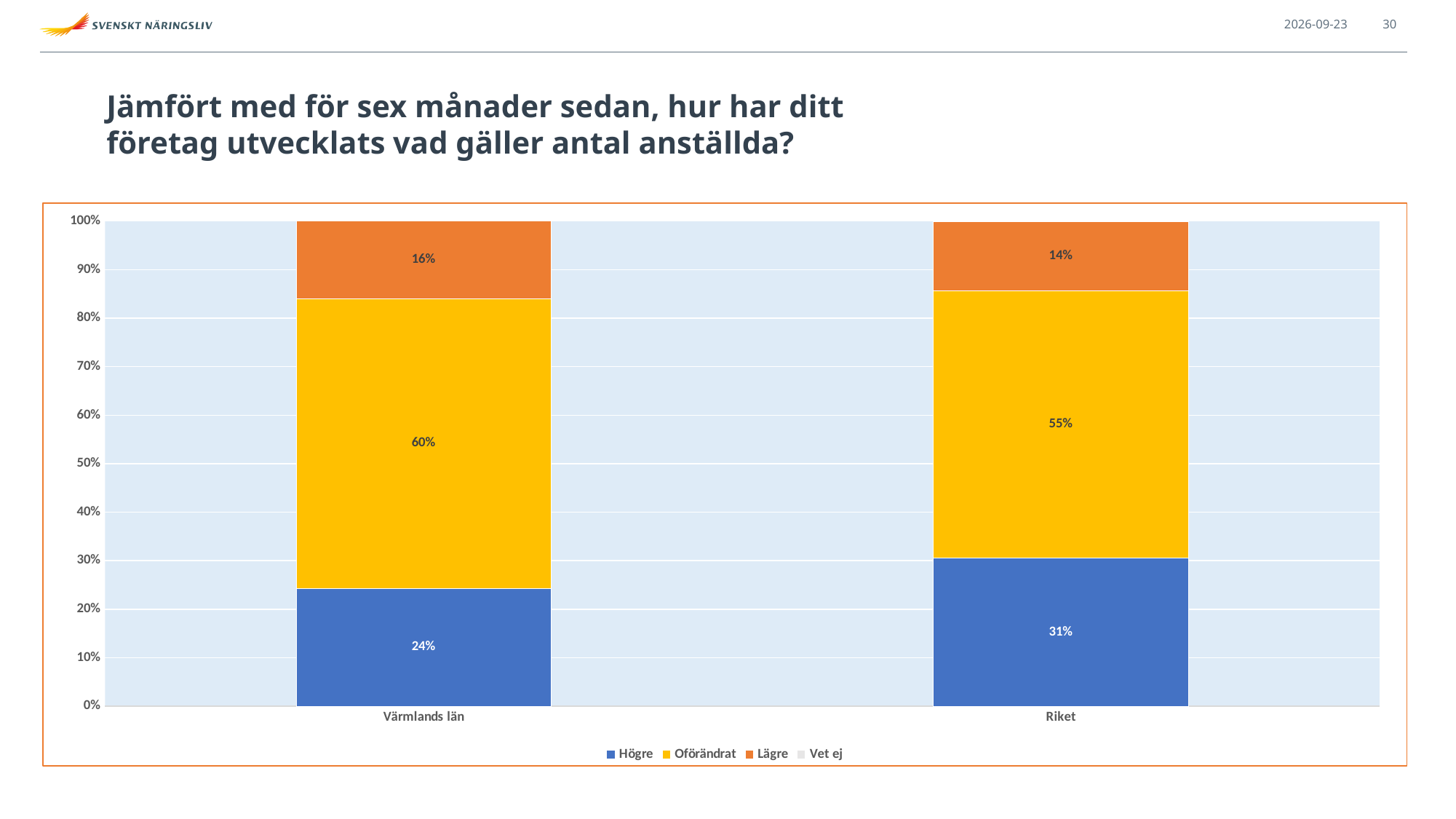
How many series does the legend list? 4 What is the value for Lägre in Värmlands län? 16% What kind of chart is shown on the slide? Stacked bar chart How many categories are shown on the x axis? 2 Which labelled series has the smallest value in the Värmlands län bar? Lägre Which series has the largest value in the Riket bar? Oförändrat What is the value for Högre in Riket? 31% Which category has the higher value for Oförändrat, Värmlands län or Riket? Värmlands län What is the value for Oförändrat in Riket? 55% What is the difference between the Lägre values for Värmlands län and Riket? 2% What is the difference between the Högre values for Riket and Värmlands län? 7% What is the value for Högre in Värmlands län? 24%